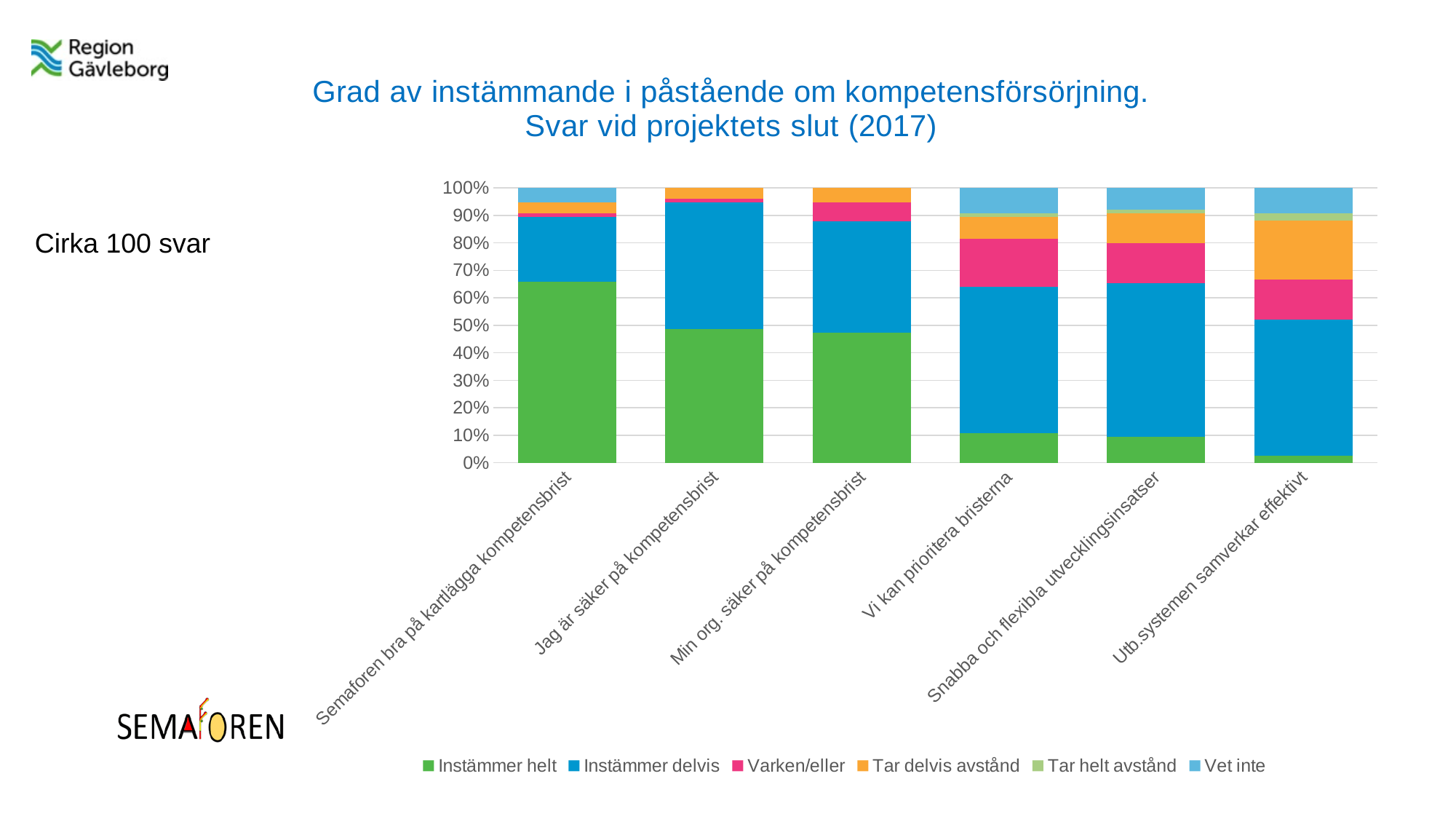
How many categories (statements) are shown along the x axis of the chart? 6 What kind of chart is shown on the slide? Stacked bar chart Which category has the largest 'Instämmer helt' share? Semaforen bra på kartlägga kompetensbrist What is the title of the chart? Grad av instämmande i påstående om kompetensförsörjning. Svar vid projektets slut (2017) Which category has the smallest 'Instämmer helt' share? Utb.systemen samverkar effektivt Is the 'Instämmer helt' share for 'Semaforen bra på kartlägga kompetensbrist' greater or less than 60%? greater How many series does the chart's legend list? 6 Which has a larger 'Instämmer helt' share: 'Semaforen bra på kartlägga kompetensbrist' or 'Vi kan prioritera bristerna'? Semaforen bra på kartlägga kompetensbrist Which colour represents 'Instämmer helt' in the chart? Green Which category has the largest 'Tar delvis avstånd' share? Utb.systemen samverkar effektivt Is the 'Instämmer helt' share for 'Vi kan prioritera bristerna' greater or less than 20%? less Is the 'Instämmer helt' share for 'Jag är säker på kompetensbrist' greater or less than 40%? greater